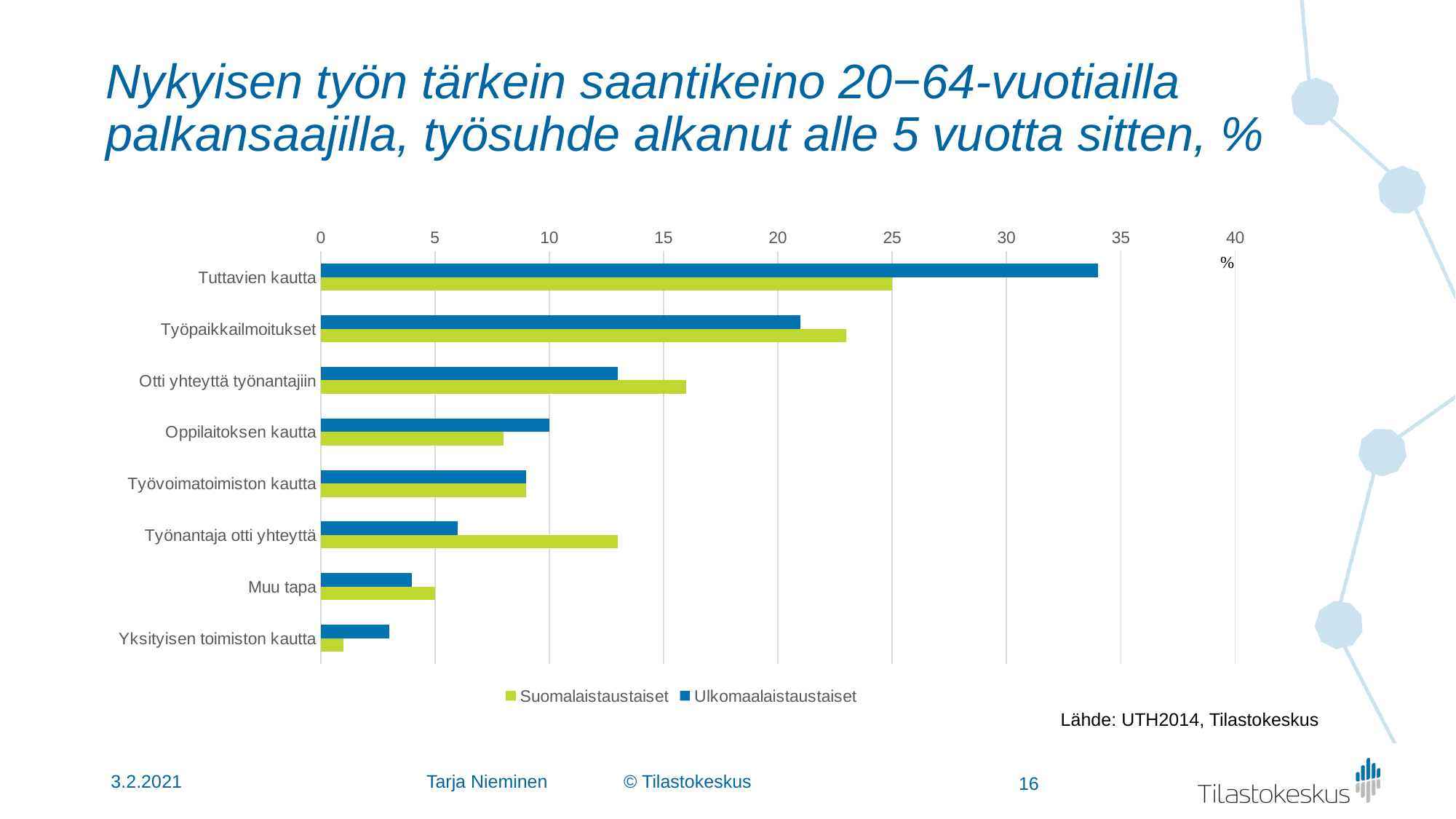
How many categories are shown on the chart? 8 How many series does the legend list? 2 Is the value for Työpaikkailmoitukset for Suomalaistaustaiset greater or less than 20? greater For Tuttavien kautta, which series has the larger value, Suomalaistaustaiset or Ulkomaalaistaustaiset? Ulkomaalaistaustaiset Which category has the highest value for Ulkomaalaistaustaiset? Tuttavien kautta Is the value for Yksityisen toimiston kautta for Ulkomaalaistaustaiset greater or less than 5? less Which colour represents the Suomalaistaustaiset series in the legend? green Is the value for Tuttavien kautta for Ulkomaalaistaustaiset greater or less than 30? greater For Työnantaja otti yhteyttä, which series has the larger value, Suomalaistaustaiset or Ulkomaalaistaustaiset? Suomalaistaustaiset Which category has the lowest value for Suomalaistaustaiset? Yksityisen toimiston kautta What kind of chart is shown on the slide? bar chart